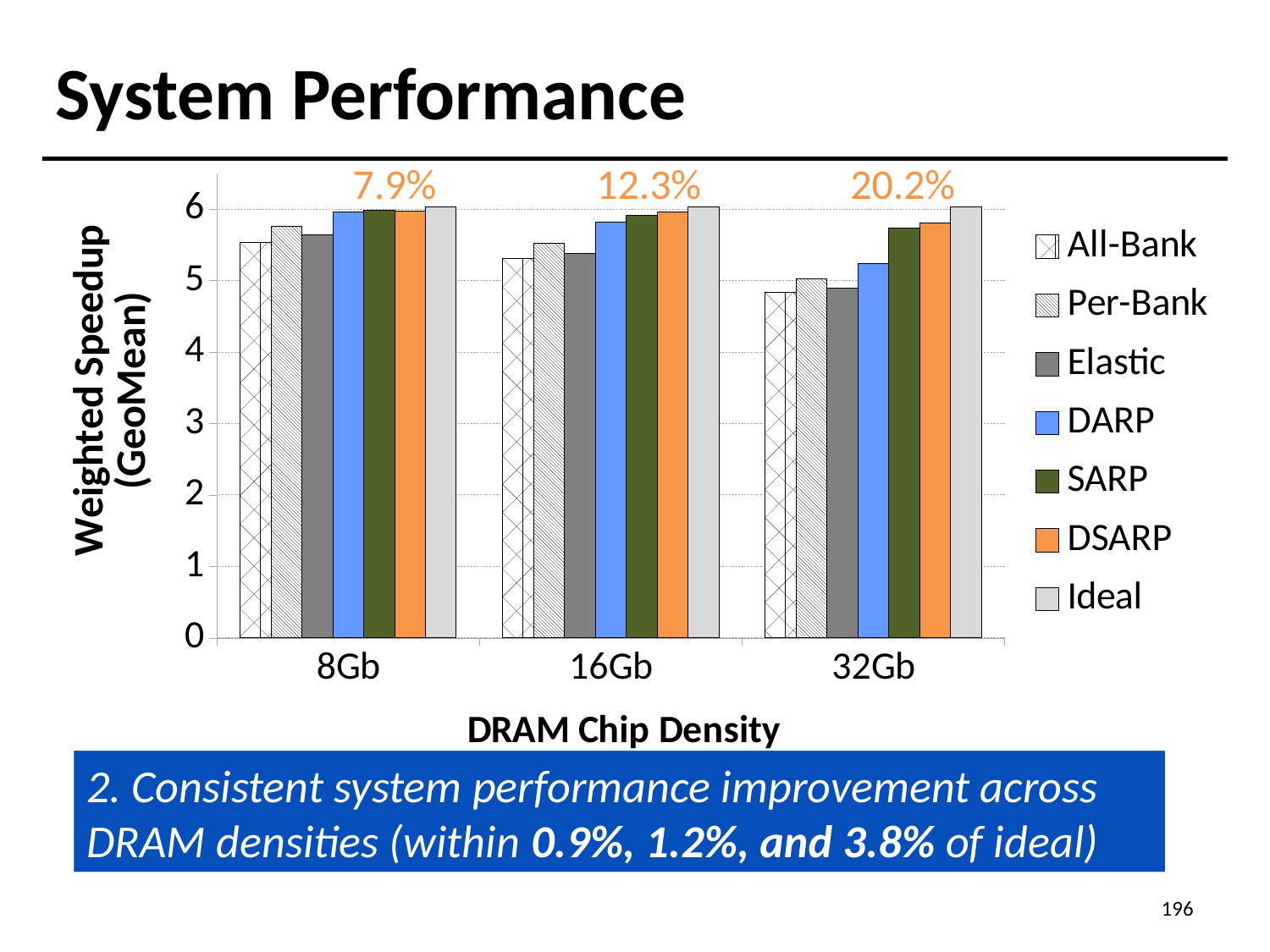
Is the value for DARP at 32Gb greater or less than 5? greater How many series does the legend list? 7 Does the All-Bank weighted speedup rise or fall as DRAM chip density increases from 8Gb to 32Gb? fall How many DRAM chip density categories are shown on the x axis? 3 What kind of chart is shown on the slide? bar chart What percentage is printed above the 32Gb group of bars? 20.2% Which series has the highest weighted speedup at 32Gb? Ideal Is the value for Ideal at 8Gb greater or less than 5? greater Is the value for All-Bank at 32Gb greater or less than 5? less At 32Gb, which is larger: the value for SARP or the value for Elastic? SARP What is the title of the x axis? DRAM Chip Density